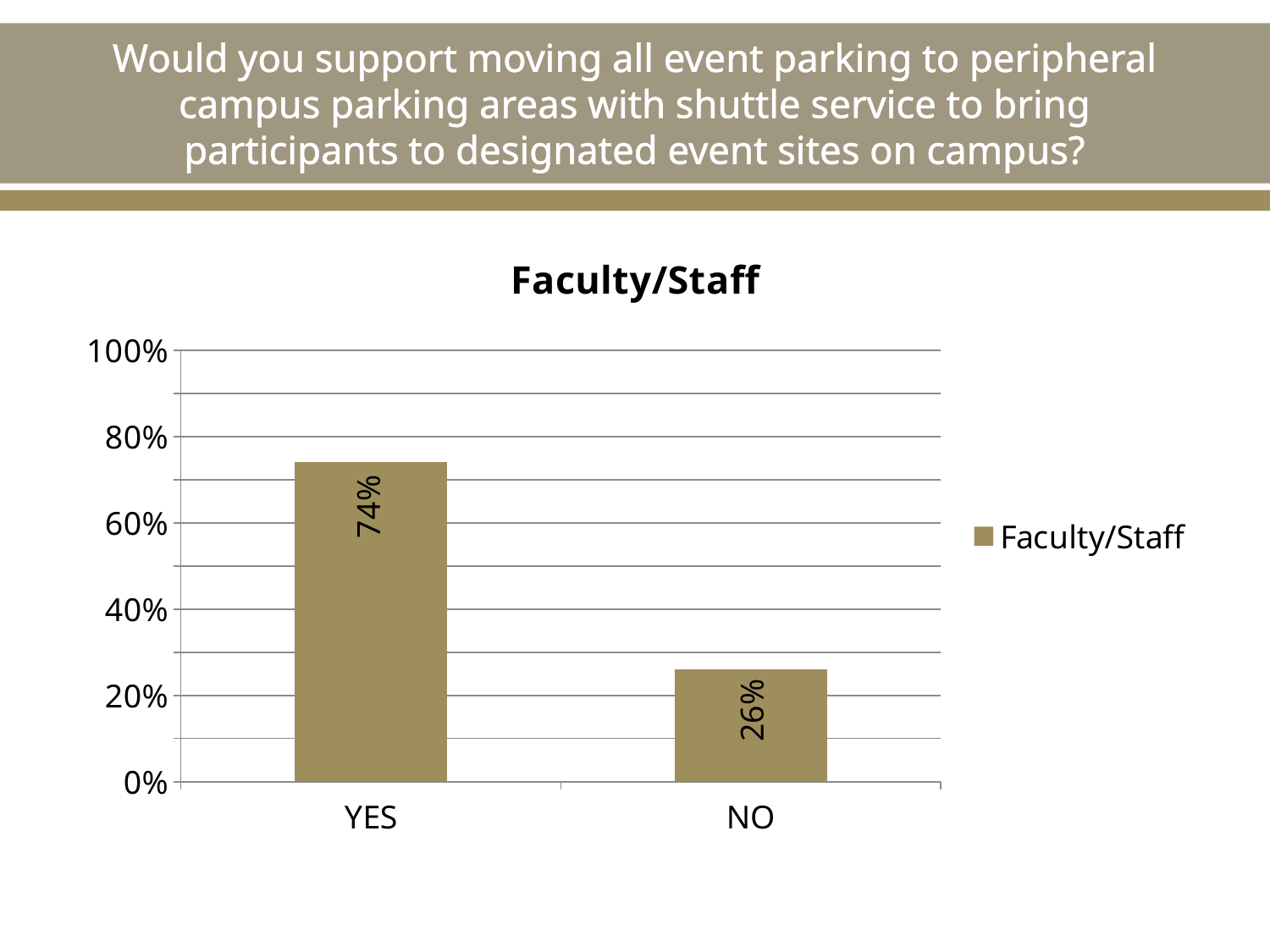
What is the value for YES? 74% What kind of chart is shown? bar chart Which is larger, the value for YES or the value for NO? YES How many series does the legend list? 1 Is the value for NO greater or less than 40%? less What is the value for NO? 26% What is the title of the chart? Faculty/Staff How many categories are shown on the x axis? 2 Which category has the lowest value? NO Is the value for YES greater or less than 60%? greater What is the difference between the YES and NO values? 48% Which category has the highest value? YES